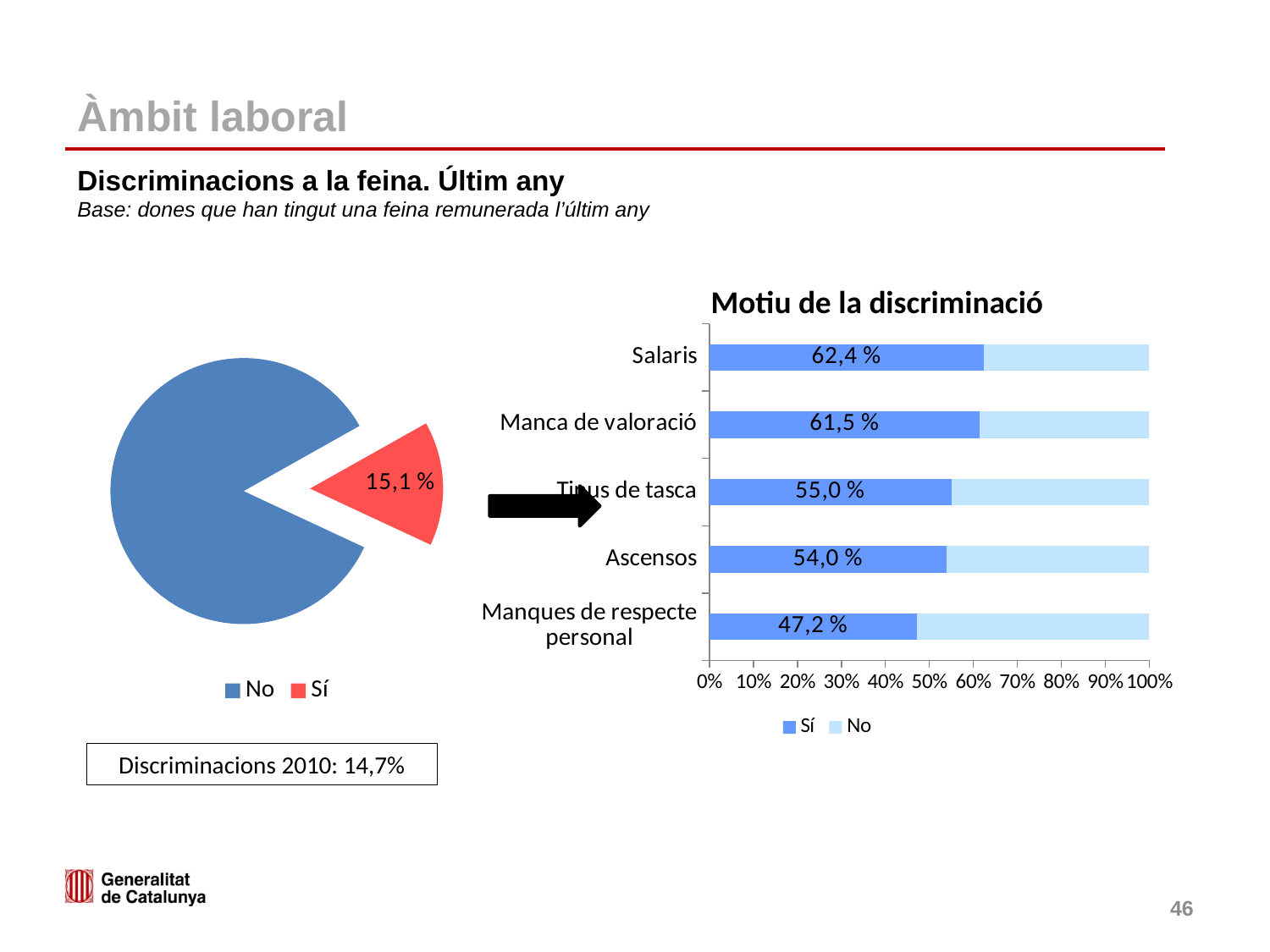
In the 'Motiu de la discriminació' chart, how many categories are shown? 5 In the 'Motiu de la discriminació' chart, what is the 'Sí' value for Ascensos? 54,0 % In the 'Motiu de la discriminació' chart, which category has the highest 'Sí' value? Salaris In the 'Motiu de la discriminació' chart, what is the difference between the 'Sí' values for Salaris and Manques de respecte personal? 15,2 % What kind of chart is the chart on the left of the slide? pie chart In the 'Motiu de la discriminació' chart, what is the 'Sí' value for Salaris? 62,4 % What kind of chart is the 'Motiu de la discriminació' chart? bar chart In the 'Motiu de la discriminació' chart, what is the 'Sí' value for Manques de respecte personal? 47,2 % In the 'Motiu de la discriminació' chart, which category has the lowest 'Sí' value? Manques de respecte personal In the pie chart on the left, what share of the pie is the 'Sí' slice? 15,1 % How many series does the legend of the pie chart on the left list? 2 In the 'Motiu de la discriminació' chart, what is the 'Sí' value for Manca de valoració? 61,5 %